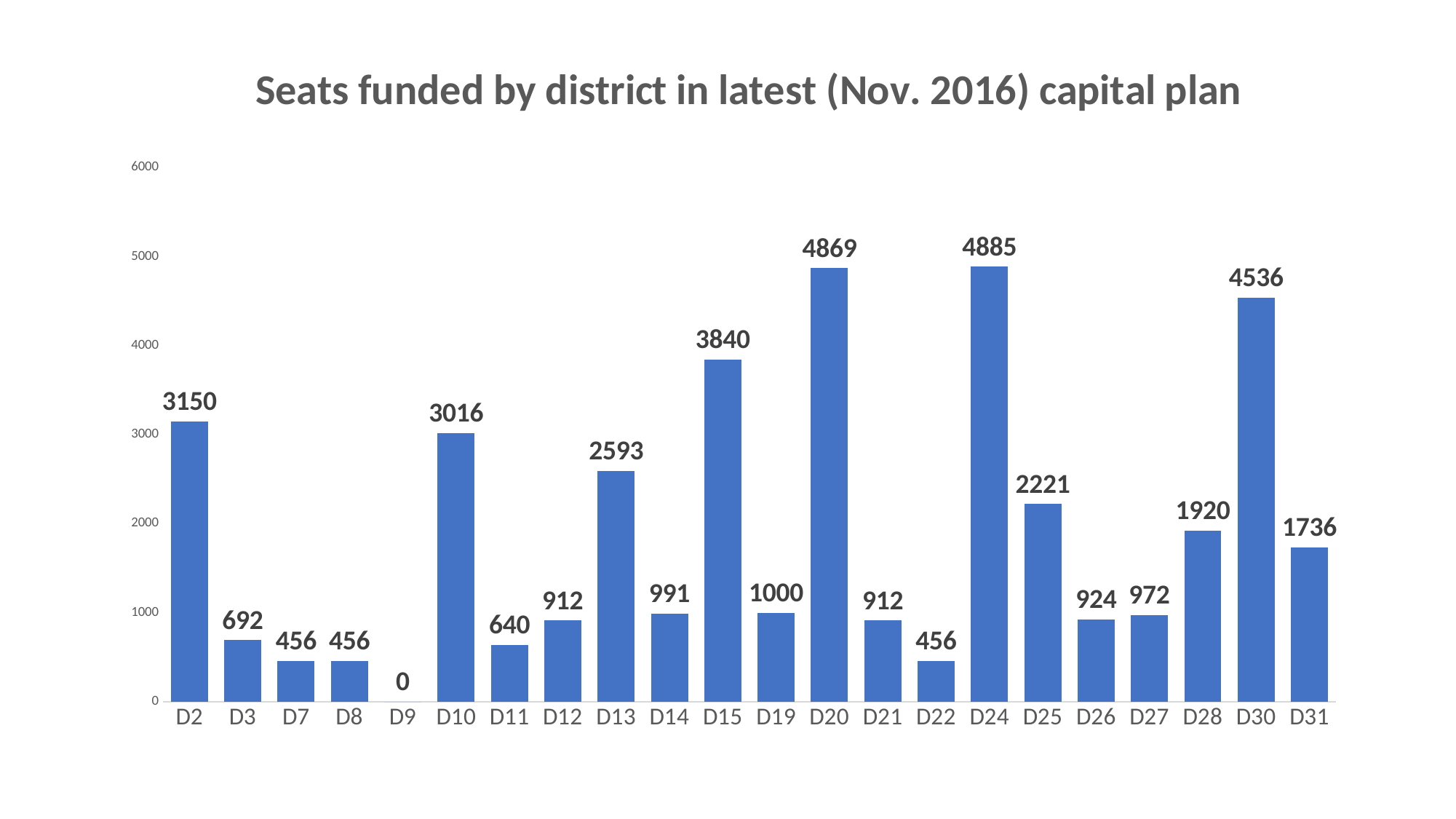
What is the value for D15? 3840 What is the value shown for D9? 0 What is the title of the chart? Seats funded by district in latest (Nov. 2016) capital plan Which has a larger value, D2 or D10? D2 What kind of chart is this? Bar chart How many districts are shown on the x axis? 22 What is the difference between the values for D24 and D20? 16 Which has a larger value, D13 or D25? D13 Which district has the highest number of seats funded? D24 Which district has the lowest number of seats funded? D9 What is the difference between the values for D30 and D31? 2800 How many seats are funded for D28? 1920